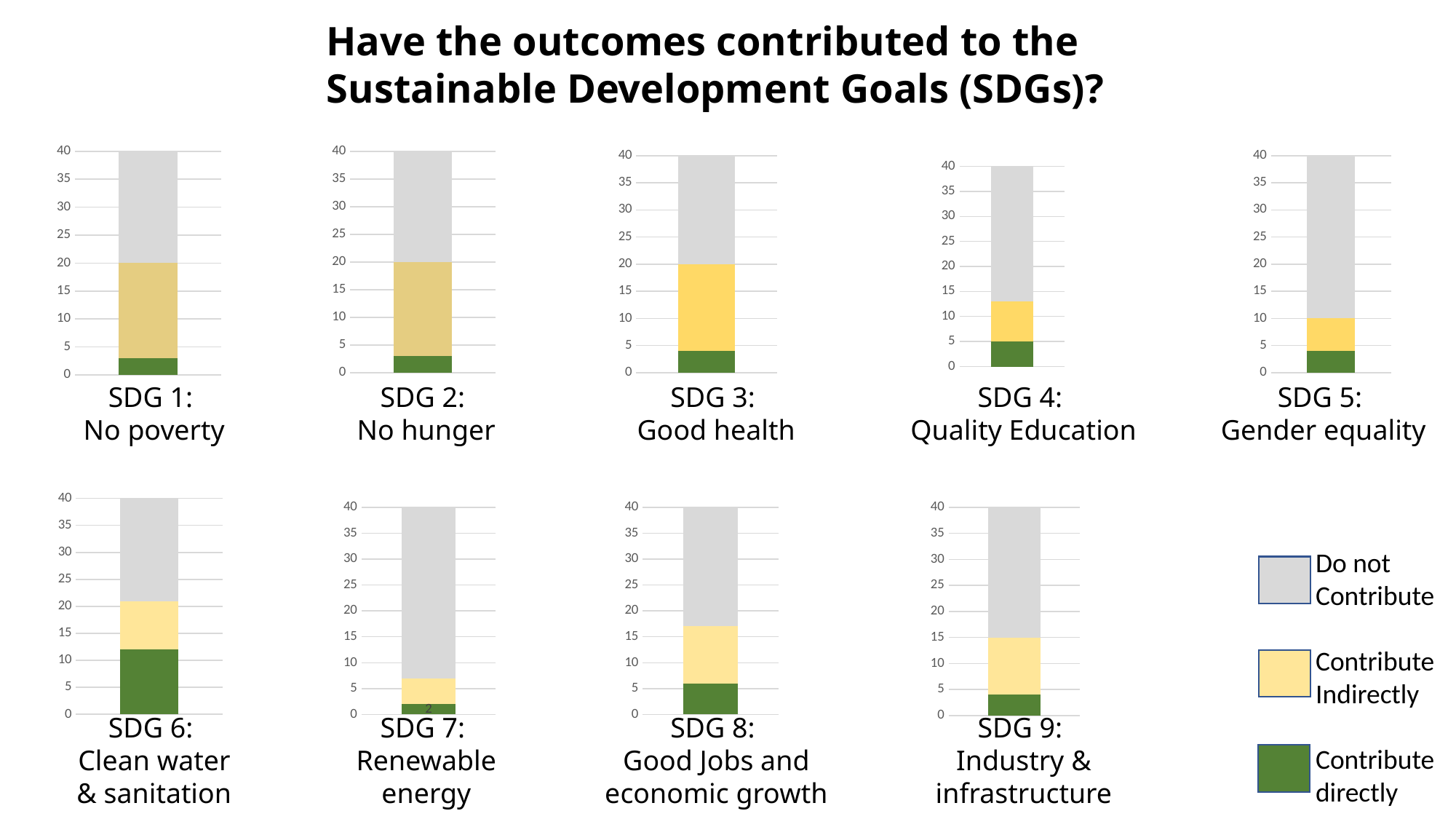
In the SDG 6: Clean water & sanitation chart, is the value for Contribute directly greater or less than 10? greater What kind of chart is used for each SDG on the slide? stacked bar chart In the SDG 8: Good Jobs and economic growth chart, is the value for Contribute directly greater or less than 10? less In the SDG 1: No poverty chart, what is the total height of the stacked bar? 40 Which has the larger Contribute directly value: the SDG 6: Clean water & sanitation chart or the SDG 7: Renewable energy chart? SDG 6: Clean water & sanitation How many series does the legend list? 3 What colour does the legend use for Do not Contribute? grey How many SDG charts are shown on the slide? 9 Which has the larger Do not Contribute value: the SDG 1: No poverty chart or the SDG 5: Gender equality chart? SDG 5: Gender equality Across all nine charts, which SDG has the largest Contribute directly segment? SDG 6: Clean water & sanitation In the SDG 7: Renewable energy chart, what is the value for Contribute directly? 2 In the SDG 7: Renewable energy chart, is the value for Do not Contribute greater or less than 30? greater